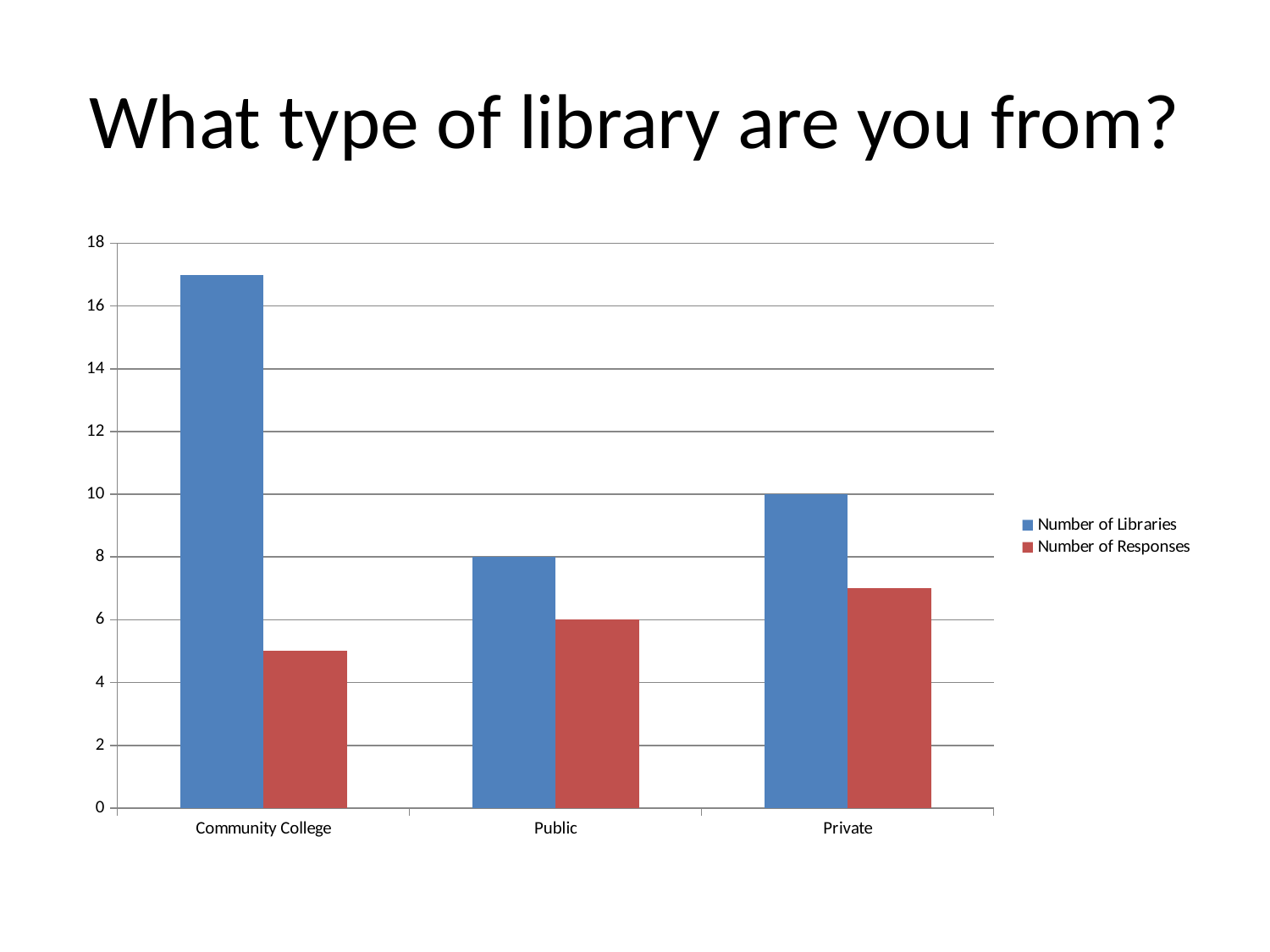
What type of chart is shown on the slide? bar chart What is the Number of Libraries for Public? 8 Which library type has the lowest Number of Responses? Community College What is the Number of Libraries for Private? 10 How many series does the legend list? 2 What is the difference between the Number of Libraries and the Number of Responses for Public? 2 How many library types are shown on the x axis? 3 Is the Number of Responses for Private greater or less than 8? less What is the Number of Responses for Public? 6 Which library type has the highest Number of Libraries? Community College Which is larger for Private: the Number of Libraries or the Number of Responses? Number of Libraries Is the Number of Libraries for Community College greater or less than 16? greater